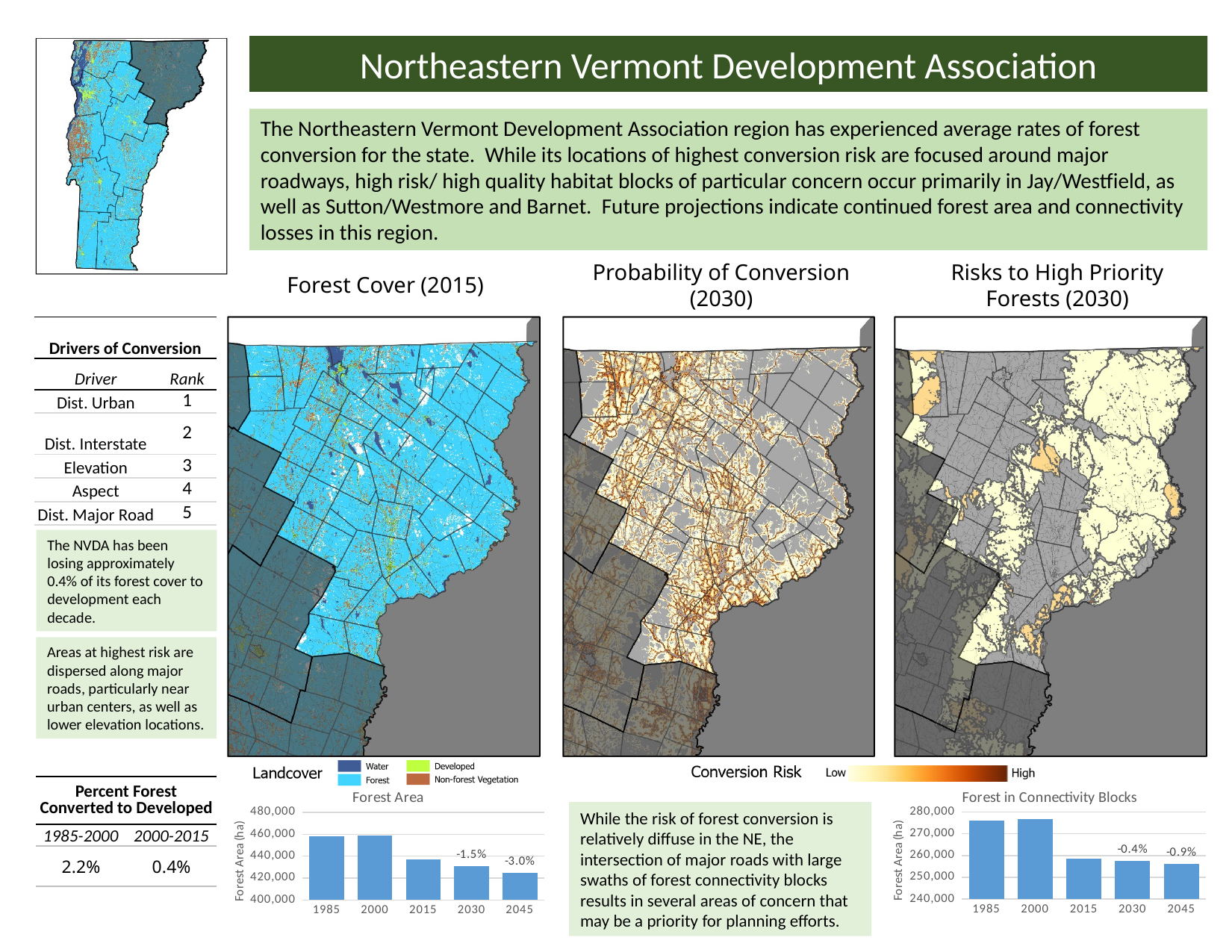
In the "Forest Area" chart, which is larger, the value for 2000 or the value for 2015? 2000 In the "Forest in Connectivity Blocks" chart, do the values generally rise or fall from 1985 to 2045? fall In the "Forest Area" chart, is the value for 2015 greater or less than 440,000? less In the "Forest Area" chart, is the value for 1985 greater or less than 440,000? greater In the "Forest Area" chart, what percentage change label is shown above the 2030 bar? -1.5% In the "Forest Area" chart, what percentage change label is shown above the 2045 bar? -3.0% In the "Forest in Connectivity Blocks" chart, what percentage change label is shown above the 2030 bar? -0.4% In the "Forest Area" chart, which year has the lowest forest area? 2045 What kind of chart is the "Forest Area" chart at the bottom left of the slide? bar chart How many years are plotted on the x axis of the "Forest Area" chart? 5 In the "Forest in Connectivity Blocks" chart, what percentage change label is shown above the 2045 bar? -0.9% In the "Forest in Connectivity Blocks" chart, is the value for 2015 greater or less than 260,000? less